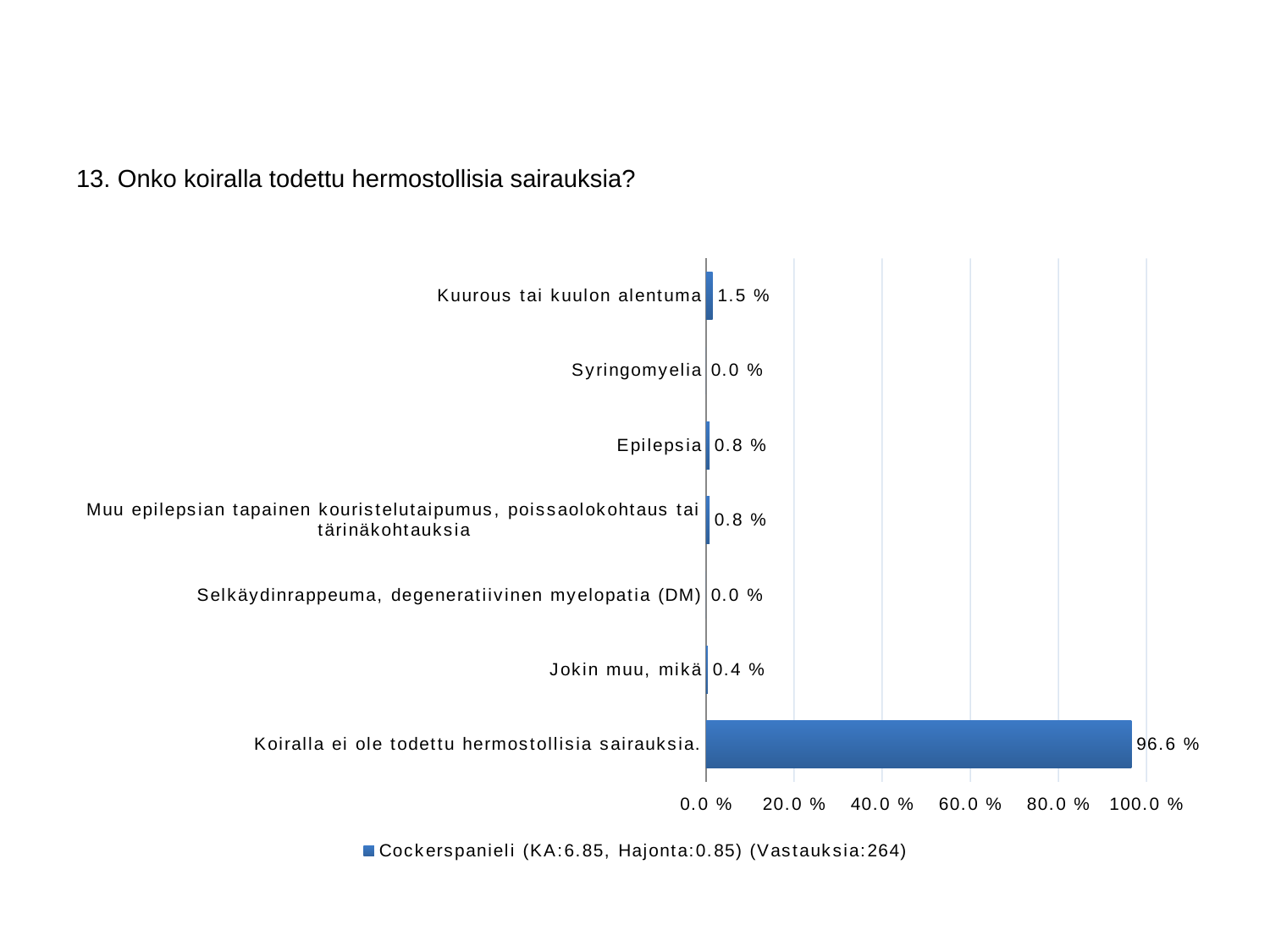
What is the difference between the values for "Koiralla ei ole todettu hermostollisia sairauksia." and "Kuurous tai kuulon alentuma"? 95.1 % What is the value for "Jokin muu, mikä"? 0.4 % Which category has the highest value? Koiralla ei ole todettu hermostollisia sairauksia. How many categories are shown on the chart? 7 What kind of chart is shown on the slide? bar chart How many categories have a value of 0.0 %? 2 Is the value for "Koiralla ei ole todettu hermostollisia sairauksia." greater or less than 80.0 %? greater Which is larger, the value for "Kuurous tai kuulon alentuma" or the value for "Epilepsia"? Kuurous tai kuulon alentuma What is the value for "Koiralla ei ole todettu hermostollisia sairauksia."? 96.6 % What is the value for "Epilepsia"? 0.8 % How many series does the legend list? 1 What is the value for "Kuurous tai kuulon alentuma"? 1.5 %